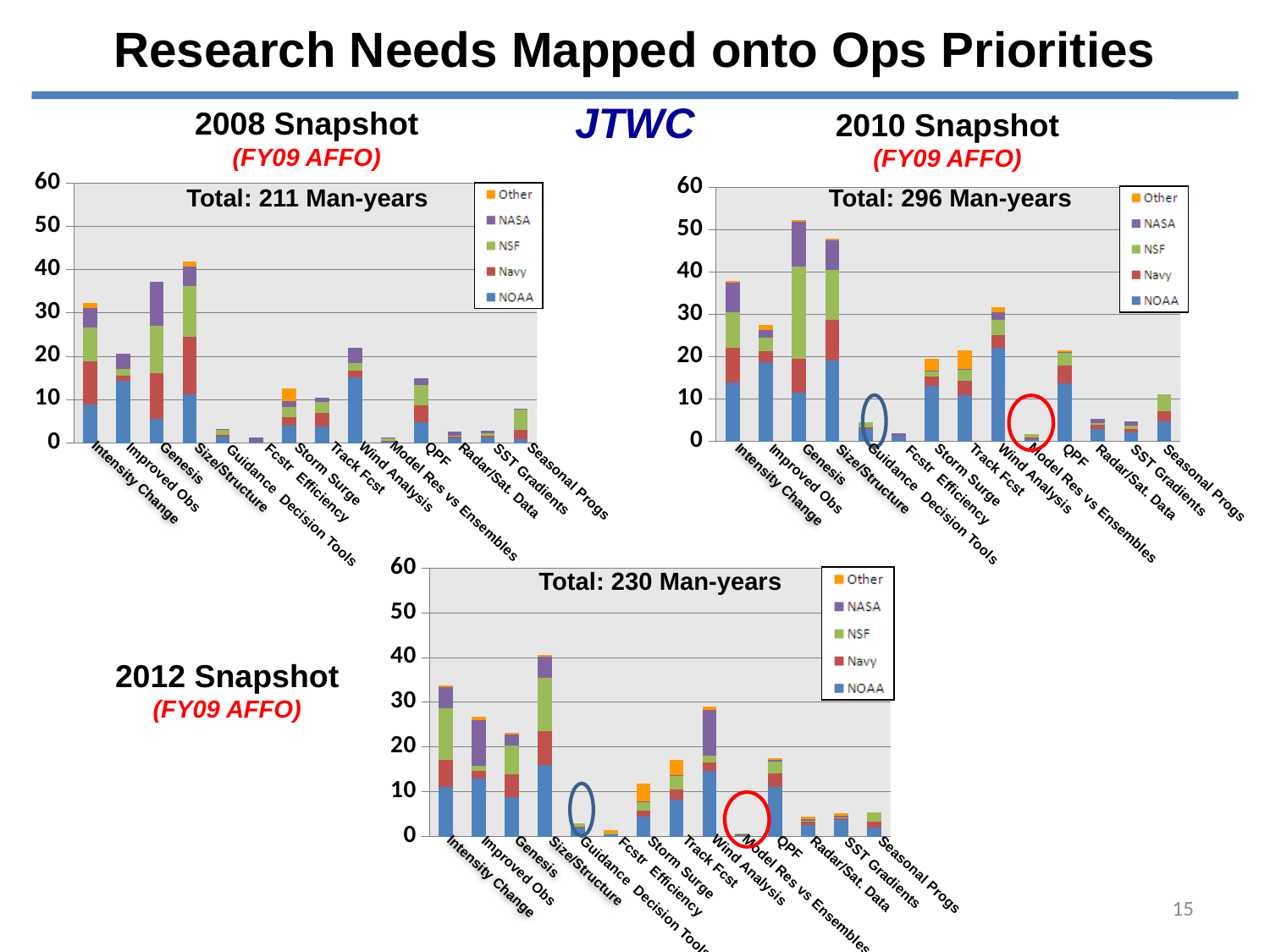
In the 2010 Snapshot chart, is the total bar for Genesis greater or less than 50? greater What total is stated in the title of the 2012 Snapshot chart? Total: 230 Man-years What kind of chart is the 2012 Snapshot chart? Stacked bar chart What total is stated in the title of the 2010 Snapshot chart? Total: 296 Man-years In the 2012 Snapshot chart, which category has the tallest stacked bar? Size/Structure In the 2010 Snapshot chart, which category has the tallest stacked bar? Genesis In the 2008 Snapshot chart, which category has the tallest stacked bar? Size/Structure In the 2008 Snapshot chart, is the total bar for Intensity Change greater or less than 30? greater In the 2010 Snapshot chart, which has the taller bar, Track Fcst or Storm Surge? Track Fcst How many categories are shown on the x axis of the 2008 Snapshot chart? 14 How many series does the legend of the 2012 Snapshot chart list? 5 What total is stated in the title of the 2008 Snapshot chart? Total: 211 Man-years